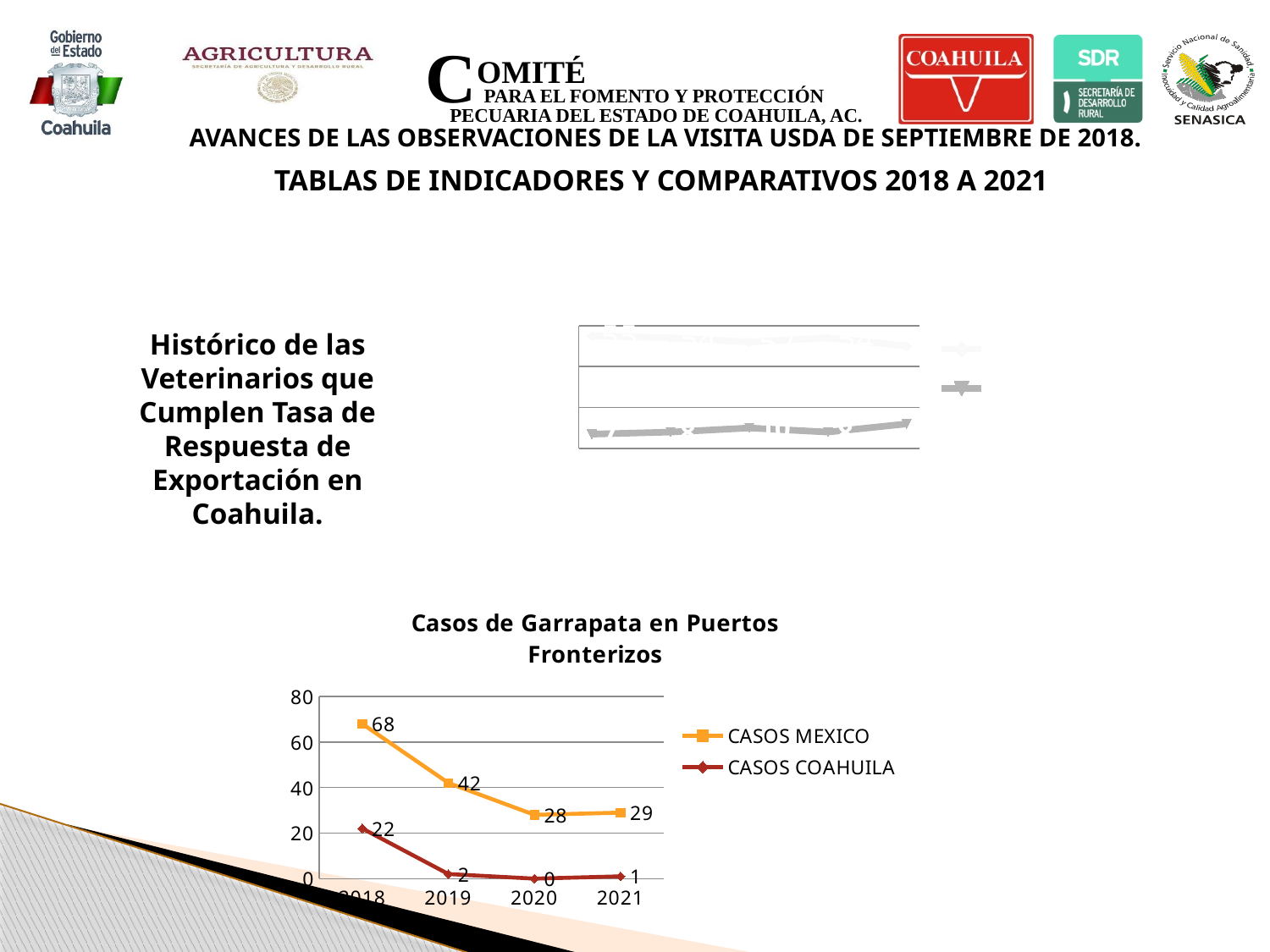
In the chart titled "Casos de Garrapata en Puertos Fronterizos", what is the value for CASOS MEXICO in 2021? 29 What kind of chart is the one titled "Casos de Garrapata en Puertos Fronterizos"? Line chart In the chart titled "Casos de Garrapata en Puertos Fronterizos", what is the difference between CASOS MEXICO and CASOS COAHUILA in 2018? 46 In the chart titled "Casos de Garrapata en Puertos Fronterizos", how many years are shown on the x axis? 4 In the chart titled "Casos de Garrapata en Puertos Fronterizos", how many series does the legend list? 2 In the chart titled "Casos de Garrapata en Puertos Fronterizos", does CASOS MEXICO rise or fall from 2018 to 2020? Fall In the chart titled "Casos de Garrapata en Puertos Fronterizos", is the value for CASOS MEXICO in 2019 greater or less than 40? greater In the chart titled "Casos de Garrapata en Puertos Fronterizos", what is the value for CASOS MEXICO in 2018? 68 In the chart titled "Casos de Garrapata en Puertos Fronterizos", what is the value for CASOS COAHUILA in 2019? 2 In the chart titled "Casos de Garrapata en Puertos Fronterizos", which is larger: CASOS MEXICO in 2019 or CASOS MEXICO in 2020? CASOS MEXICO in 2019 In the chart titled "Casos de Garrapata en Puertos Fronterizos", in which year is CASOS COAHUILA lowest? 2020 In the chart titled "Casos de Garrapata en Puertos Fronterizos", in which year is CASOS MEXICO highest? 2018